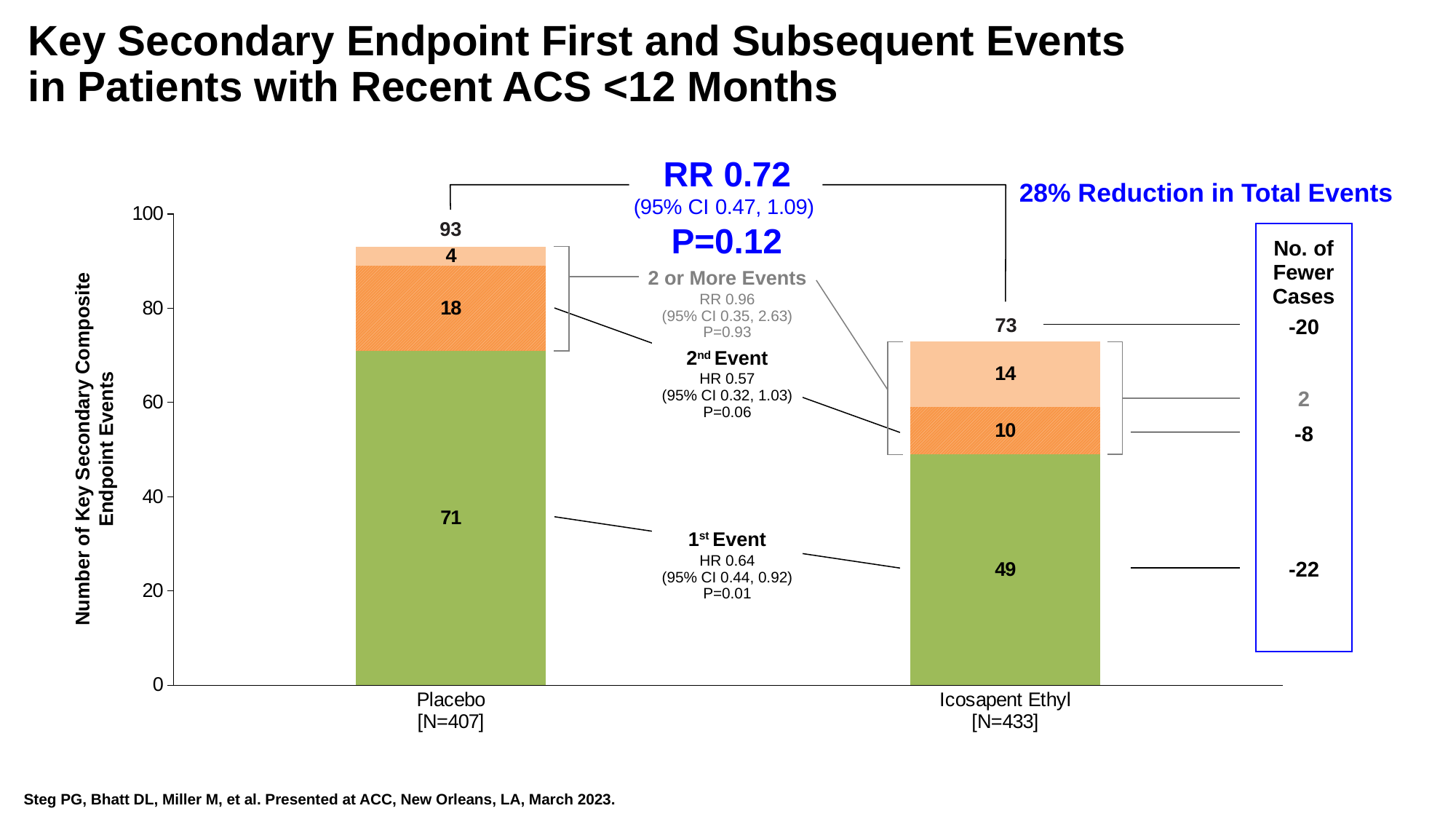
What kind of chart is shown on the slide? Stacked bar chart Which group has the higher total number of events, Placebo or Icosapent Ethyl? Placebo How many 2nd events are shown for the Icosapent Ethyl group? 10 What is the difference in 1st events between the Placebo and Icosapent Ethyl groups? 22 How many 1st events are shown for the Icosapent Ethyl group? 49 What is the difference in 2nd events between the Placebo and Icosapent Ethyl groups? 8 How many 1st events are shown for the Placebo group? 71 How many '2 or more events' are shown for the Placebo group? 4 What is the total number of key secondary composite endpoint events in the Icosapent Ethyl group? 73 What is the total number of key secondary composite endpoint events in the Placebo group? 93 What is the number of patients in the Icosapent Ethyl group shown on the x-axis label? N=433 How many treatment groups (bars) are shown on the chart? 2